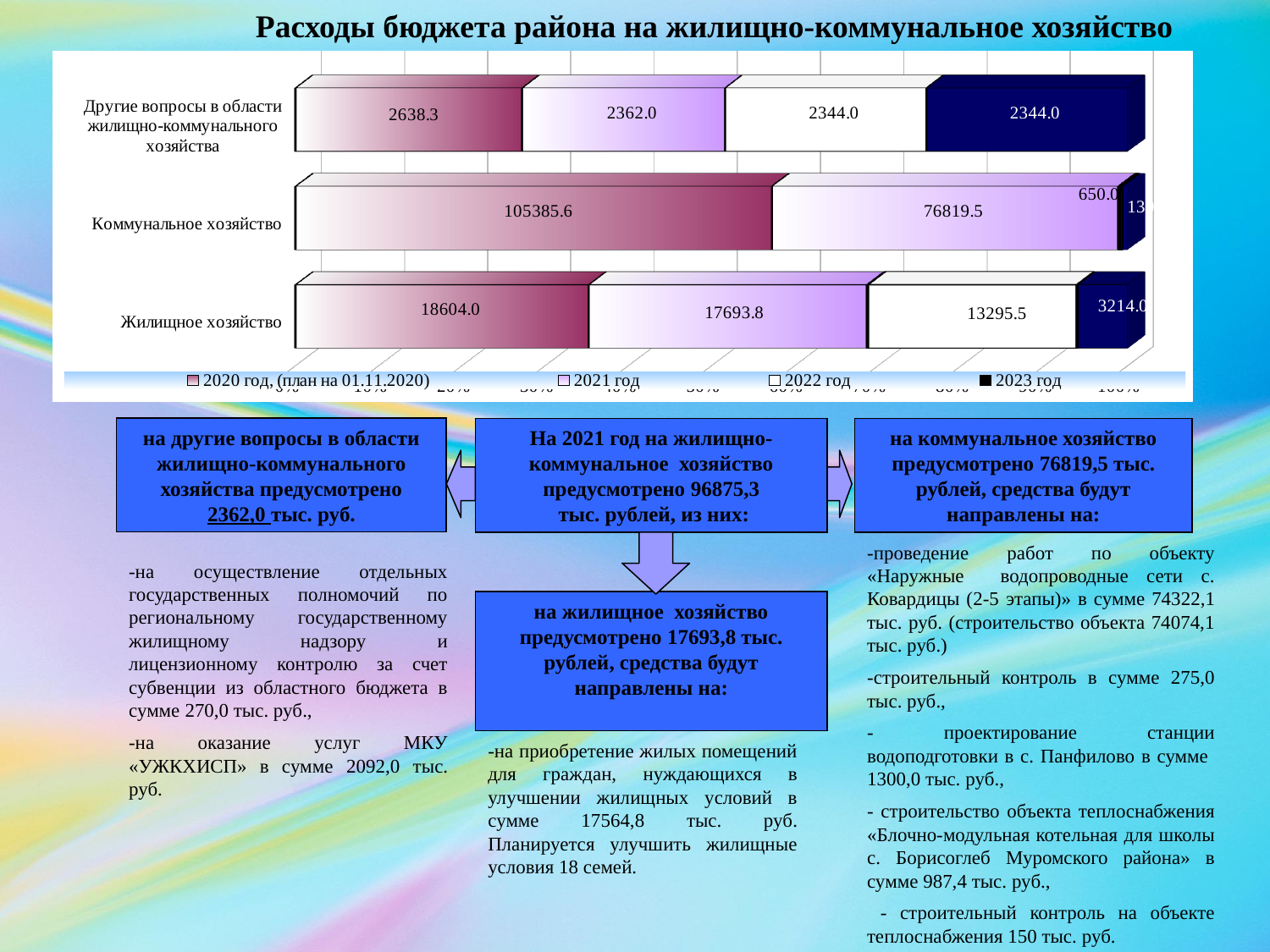
What is the difference between the 2020 год and 2021 год values for Другие вопросы в области жилищно-коммунального хозяйства? 276.3 What is the difference between the 2020 год and 2021 год values for Жилищное хозяйство? 910.2 How many series does the legend list? 4 How many categories are shown on the chart? 3 What is the value for Коммунальное хозяйство in the 2020 год (план на 01.11.2020) series? 105385.6 Which category has the highest value in the 2020 год (план на 01.11.2020) series? Коммунальное хозяйство What is the value for Другие вопросы в области жилищно-коммунального хозяйства in the 2022 год series? 2344.0 Which category has the lowest value in the 2021 год series? Другие вопросы в области жилищно-коммунального хозяйства In the 2022 год series, which is larger: Жилищное хозяйство or Другие вопросы в области жилищно-коммунального хозяйства? Жилищное хозяйство What is the value for Жилищное хозяйство in the 2021 год series? 17693.8 What is the value for Жилищное хозяйство in the 2023 год series? 3214.0 What kind of chart is shown on the slide? Stacked bar chart